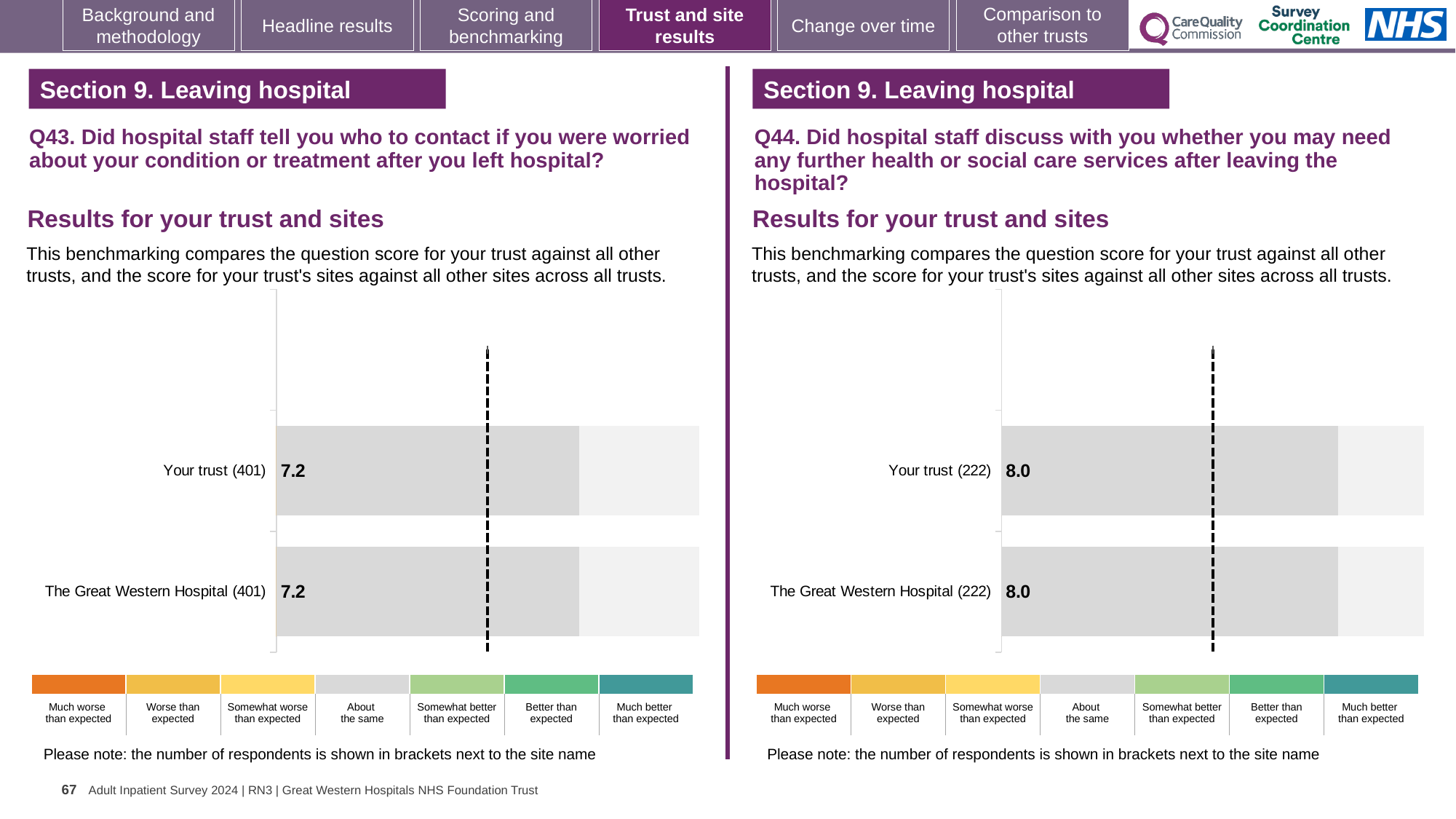
How many bars are plotted on the right chart (Q44)? 2 On the right chart (Q44), what is the score for The Great Western Hospital? 8.0 On the left chart (Q43), is the score for Your trust larger, smaller, or the same as the score for The Great Western Hospital? The same What is the difference between the Your trust score on the right chart (Q44) and the Your trust score on the left chart (Q43)? 0.8 On the left chart (Q43), what is the score for The Great Western Hospital? 7.2 On the right chart (Q44), how many respondents are shown in brackets next to The Great Western Hospital? 222 How many categories are shown on the left chart (Q43)? 2 On the right chart (Q44), what is the score for Your trust? 8.0 What kind of chart is used on the left (Q43) side of the slide? Bar chart On the left chart (Q43), how many respondents are shown in brackets next to Your trust? 401 On the left chart (Q43), what is the score for Your trust? 7.2